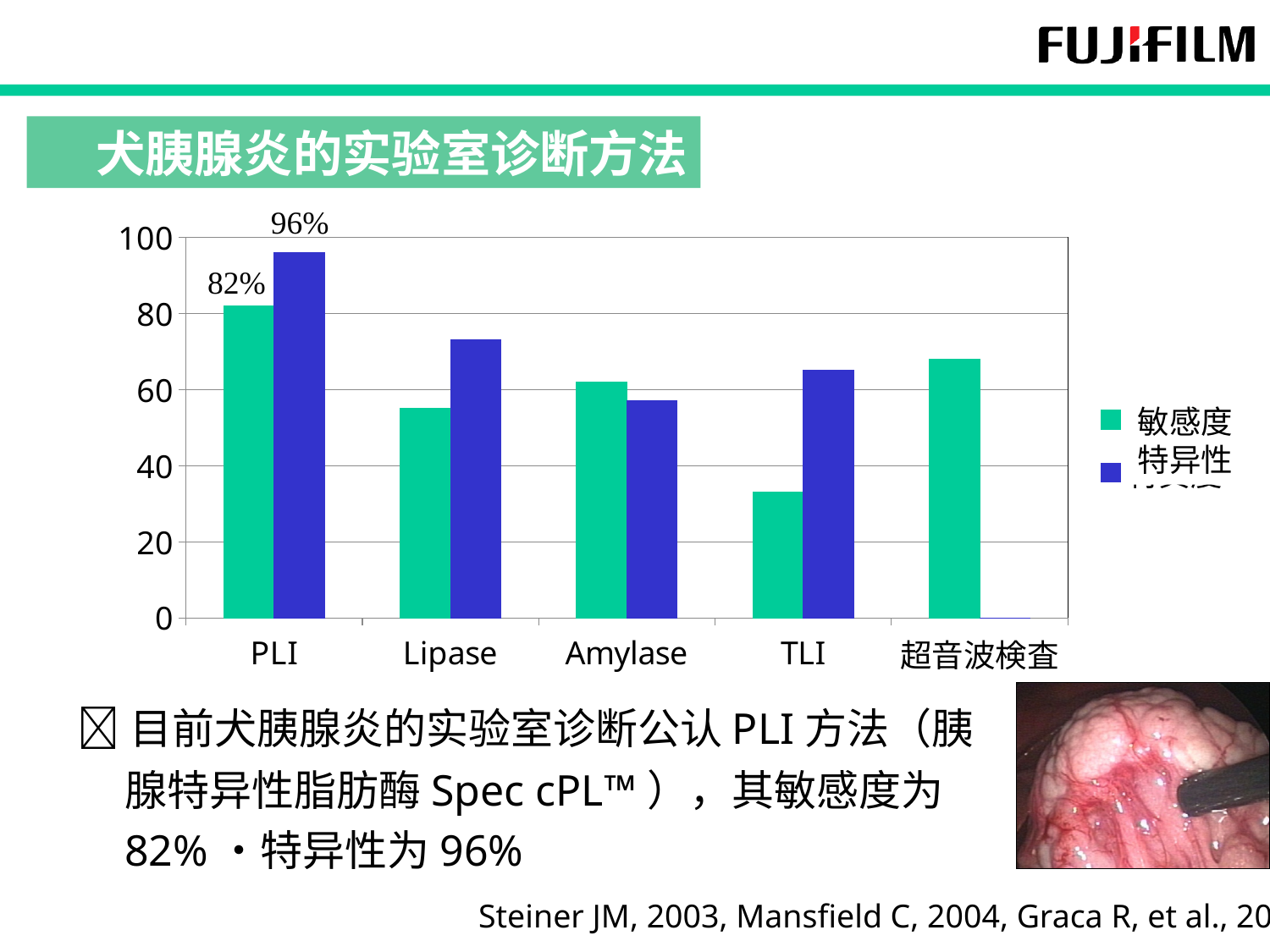
What is the 敏感度 (sensitivity) value for PLI? 82% What is the 特异性 (specificity) value for PLI? 96% What colour represents 敏感度 in the chart legend? green What is the difference between the 特异性 and 敏感度 values for PLI? 14% How many series does the chart legend list? 2 Which category has the highest 敏感度 (sensitivity) bar? PLI How many categories are shown on the x axis of the chart? 5 For Lipase, which is larger: the 敏感度 bar or the 特异性 bar? 特异性 Is the 敏感度 value for TLI greater or less than 40? less What kind of chart is shown on the slide? bar chart Is the 特异性 value for Lipase greater or less than 60? greater Which category has the lowest 敏感度 (sensitivity) bar? TLI